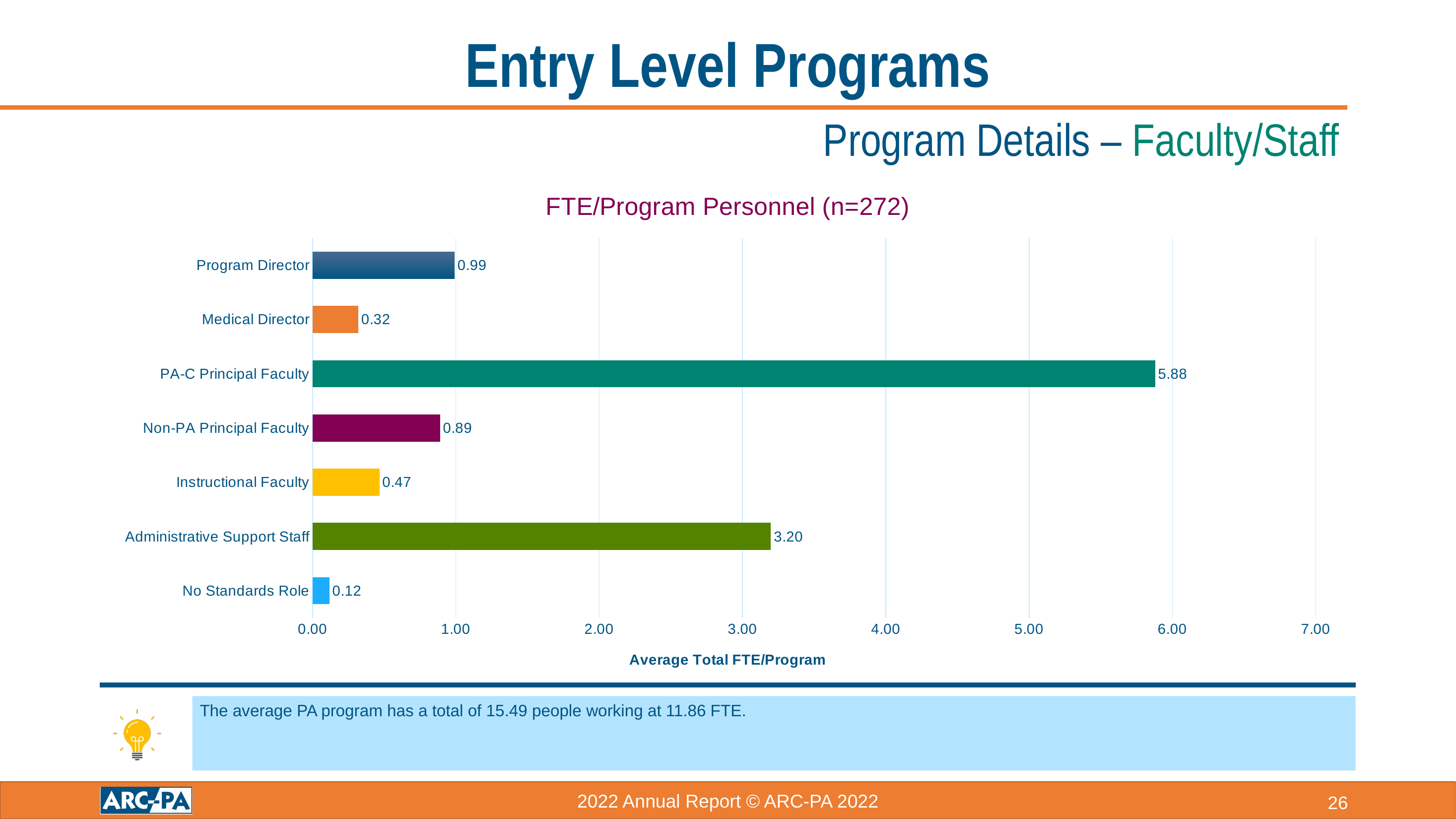
Which category has the highest average total FTE/program? PA-C Principal Faculty What is the title of the chart? FTE/Program Personnel (n=272) What is the difference between the values for PA-C Principal Faculty and Administrative Support Staff? 2.68 Which is larger, the value for Program Director or the value for Non-PA Principal Faculty? Program Director What kind of chart is shown on the slide? Bar chart What is the average total FTE/program for PA-C Principal Faculty? 5.88 What is the value shown for Medical Director? 0.32 How many categories are shown in the chart? 7 What is the average total FTE/program for Administrative Support Staff? 3.20 Which category has the lowest average total FTE/program? No Standards Role Is the value for Administrative Support Staff greater or less than 3.00? greater What is the label of the horizontal axis? Average Total FTE/Program